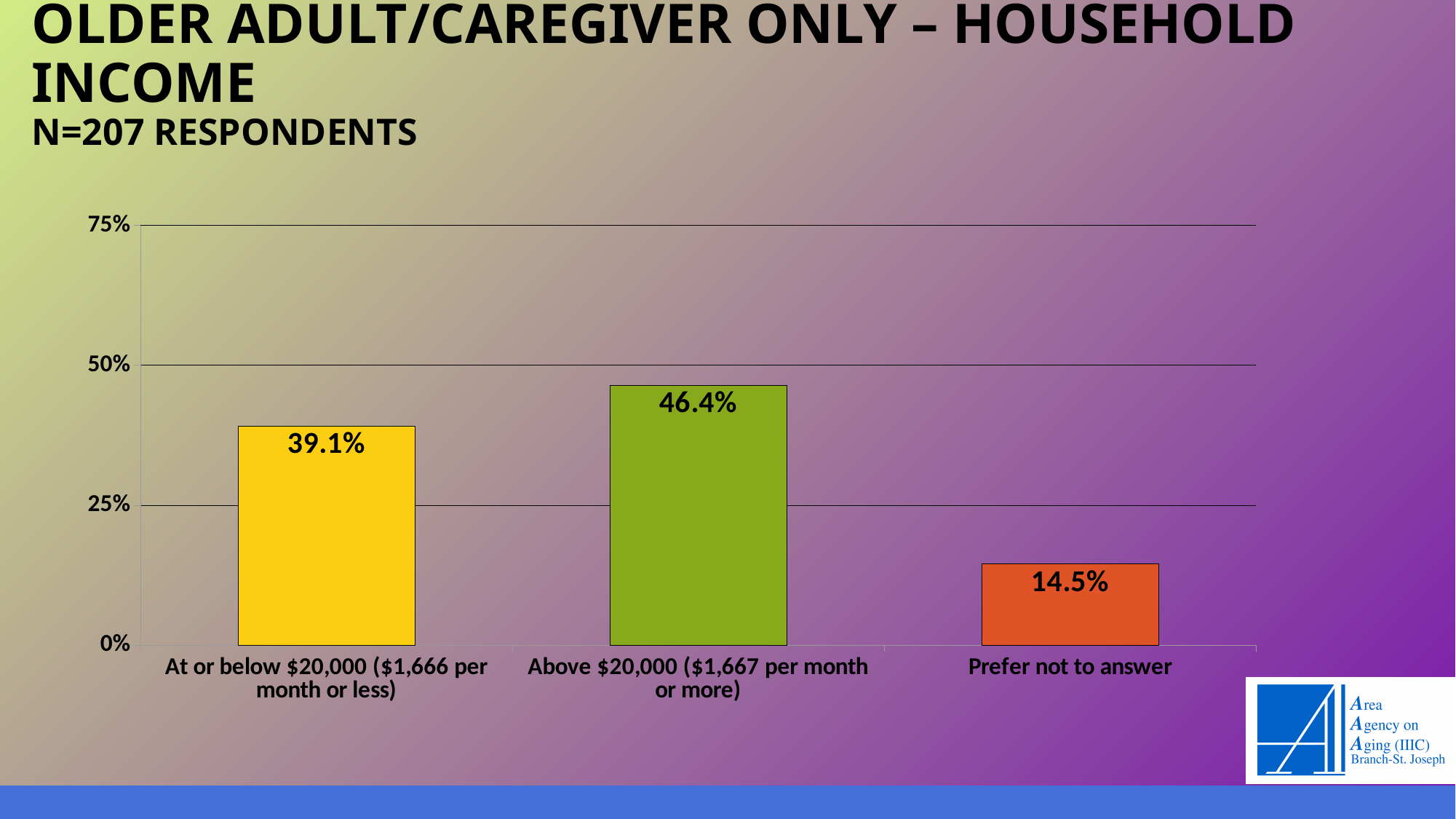
Is the value for 'Above $20,000 ($1,667 per month or more)' greater or less than 50%? less How many categories are shown on the chart? 3 Which is larger: the percentage for 'At or below $20,000' or for 'Prefer not to answer'? At or below $20,000 What percentage of respondents chose 'Prefer not to answer'? 14.5% Which category has the lowest percentage of respondents? Prefer not to answer What is the difference in percentage points between the 'Above $20,000' and 'At or below $20,000' categories? 7.3 What is the difference in percentage points between 'At or below $20,000' and 'Prefer not to answer'? 24.6 Which income category has the highest percentage of respondents? Above $20,000 ($1,667 per month or more) What percentage of respondents reported household income above $20,000 ($1,667 per month or more)? 46.4% What type of chart is shown on the slide? Bar chart What percentage of respondents reported household income at or below $20,000 ($1,666 per month or less)? 39.1% How many respondents does the slide say the chart is based on? 207